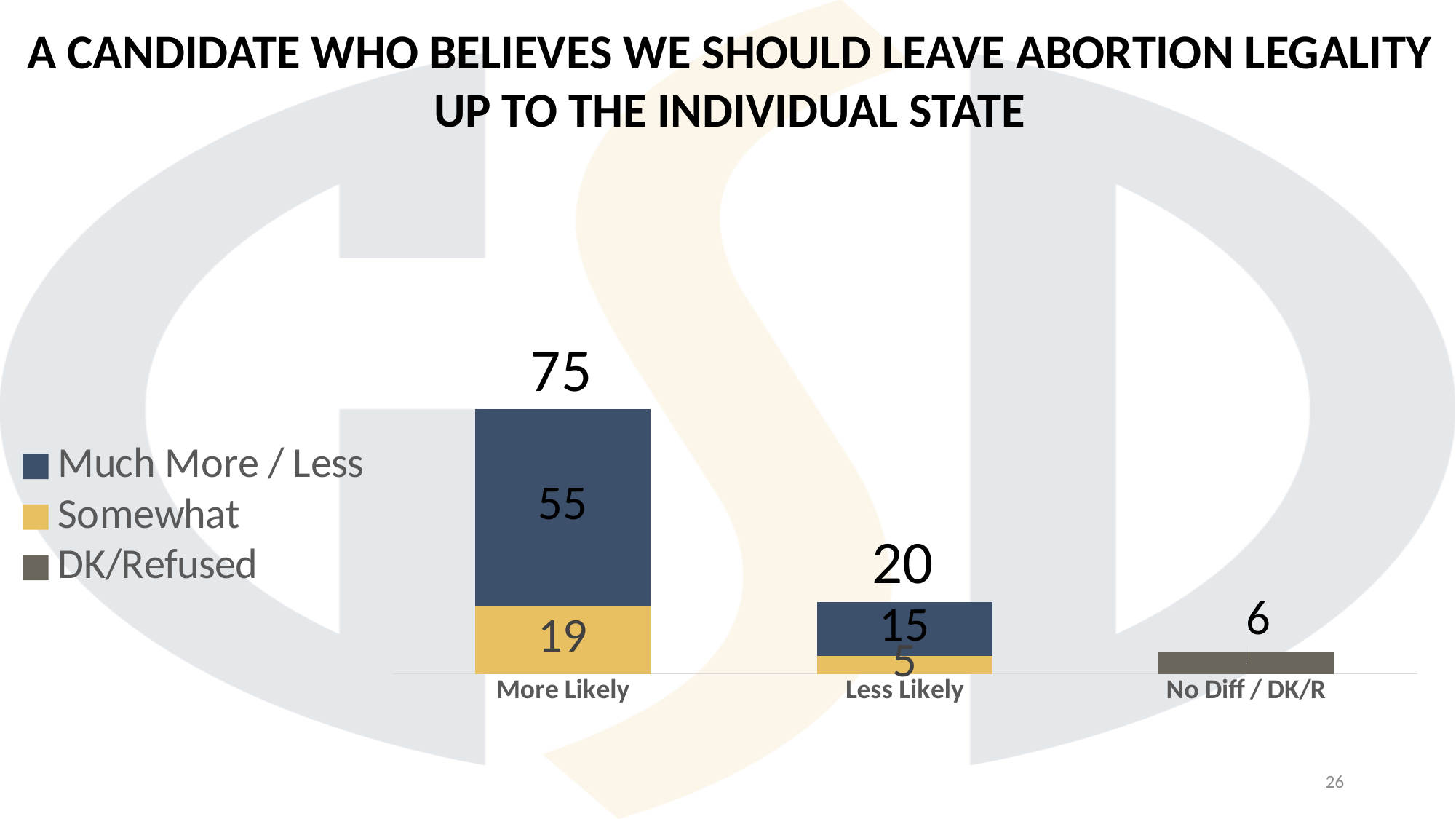
Which category has the highest total? More Likely What is the total for the More Likely bar? 75 How many series does the legend list? 3 What is the Much More / Less value for Less Likely? 15 What is the difference between the More Likely total and the Less Likely total? 55 What is the Much More / Less value for More Likely? 55 What is the Somewhat value for More Likely? 19 Which category has the lowest total? No Diff / DK/R What is the Somewhat value for Less Likely? 5 What is the value for No Diff / DK/R? 6 What is the total for the Less Likely bar? 20 What kind of chart is shown? Stacked bar chart